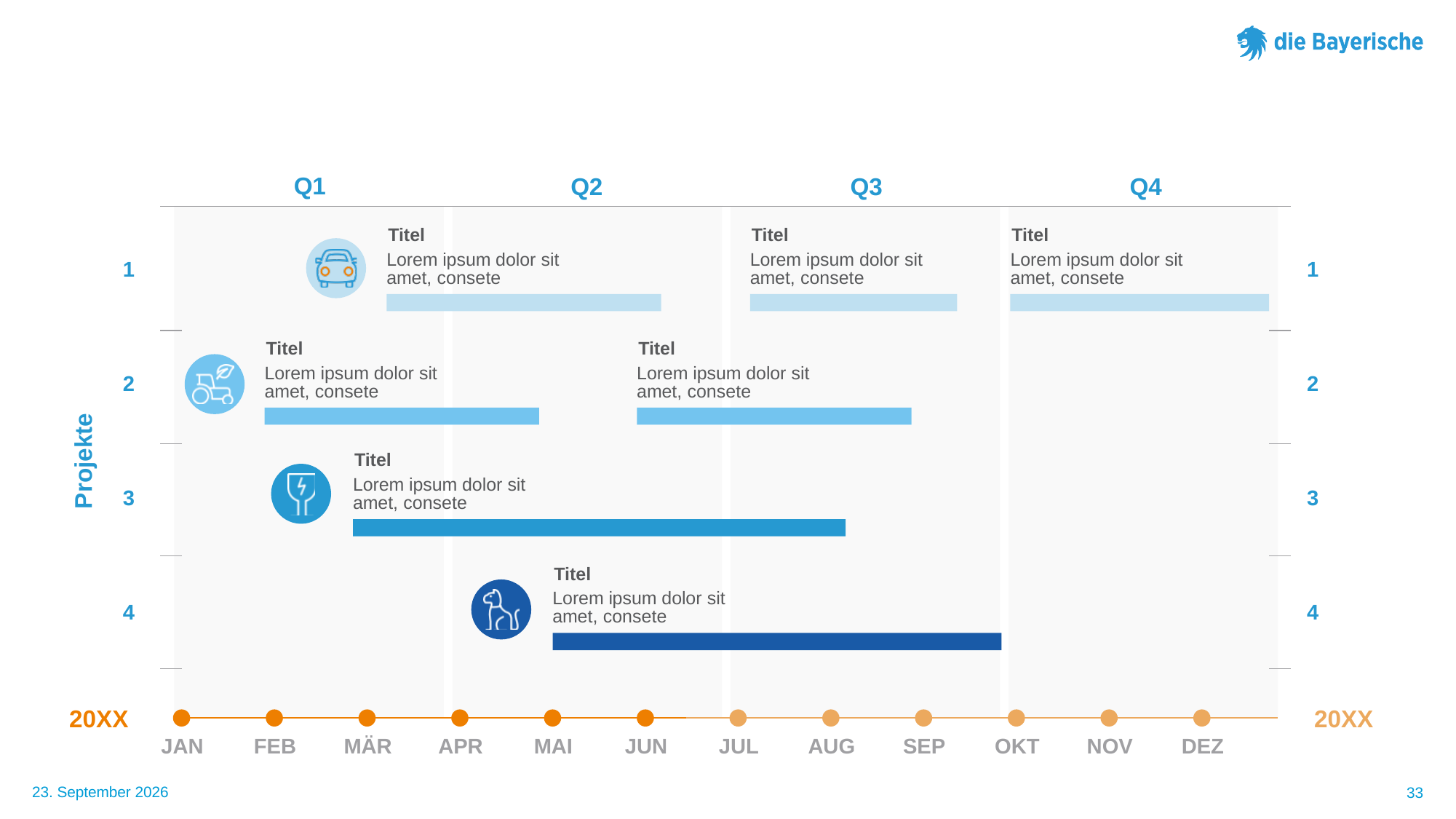
How many bars are plotted for project 1? 3 In which quarter does the bar for project 4 begin? Q2 Which project has the most bars on the timeline? Project 1 Which project's bar starts earliest in the year? Project 2 How many bars are plotted for project 2? 2 How many bars are plotted in total across all projects? 7 What kind of chart is shown on the slide? Gantt chart (project timeline) What is the label of the vertical axis? Projekte Which project is the only one with a bar in Q4? Project 1